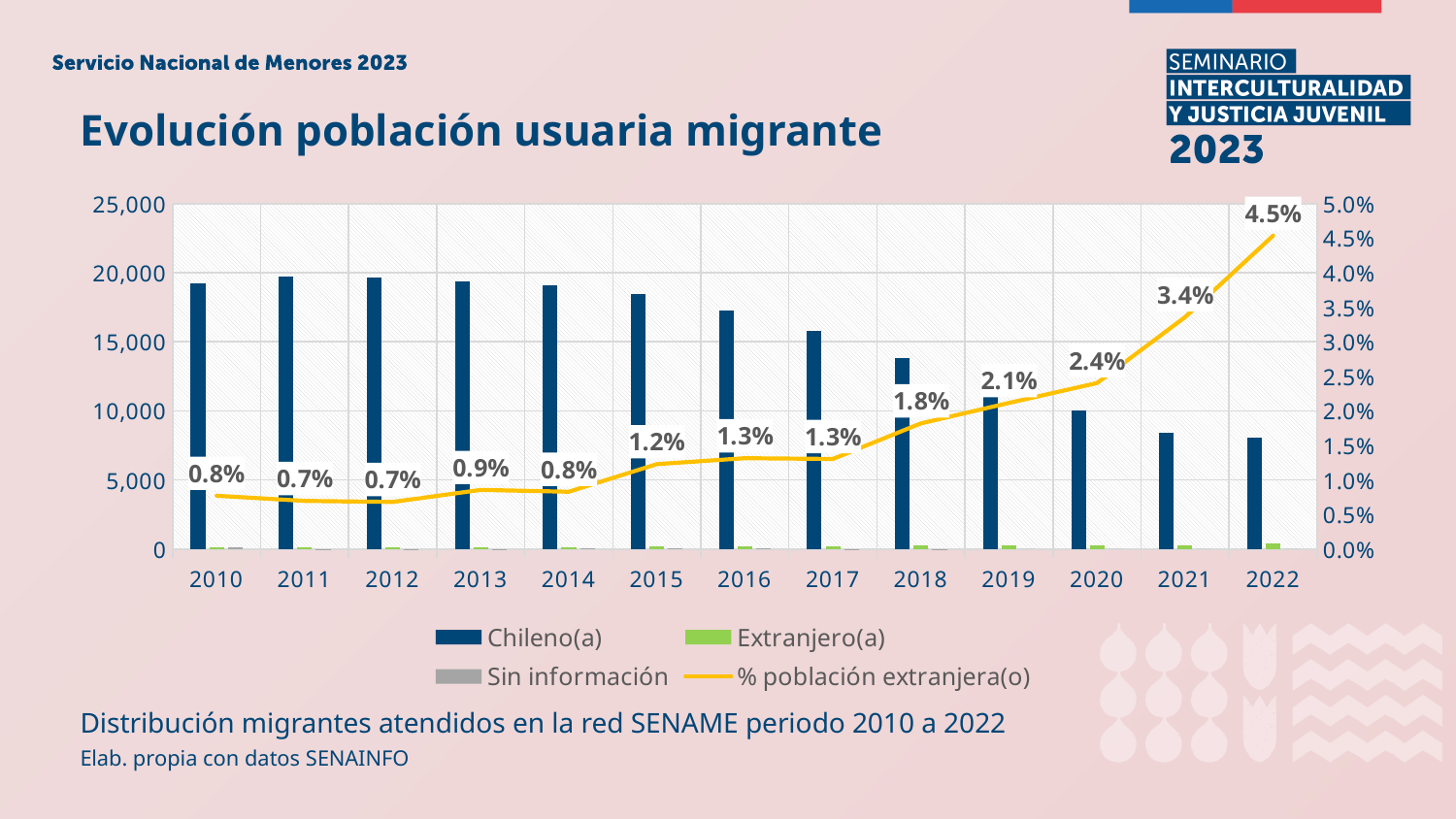
How many series does the legend list? 4 What is the value of % población extranjera(o) for 2022? 4.5% Which year has a higher % población extranjera(o), 2018 or 2020? 2020 Is the Chileno(a) value for 2022 greater or less than 10,000? less What is the difference between % población extranjera(o) in 2022 and in 2021? 1.1% What is the lowest value shown for % población extranjera(o)? 0.7% Does the % población extranjera(o) line generally rise or fall from 2014 to 2022? rise What is the value of % población extranjera(o) for 2015? 1.2% What is the value of % población extranjera(o) for 2019? 2.1% Is the Chileno(a) value for 2010 greater or less than 15,000? greater How many years are shown on the x axis? 13 In which year is % población extranjera(o) highest? 2022